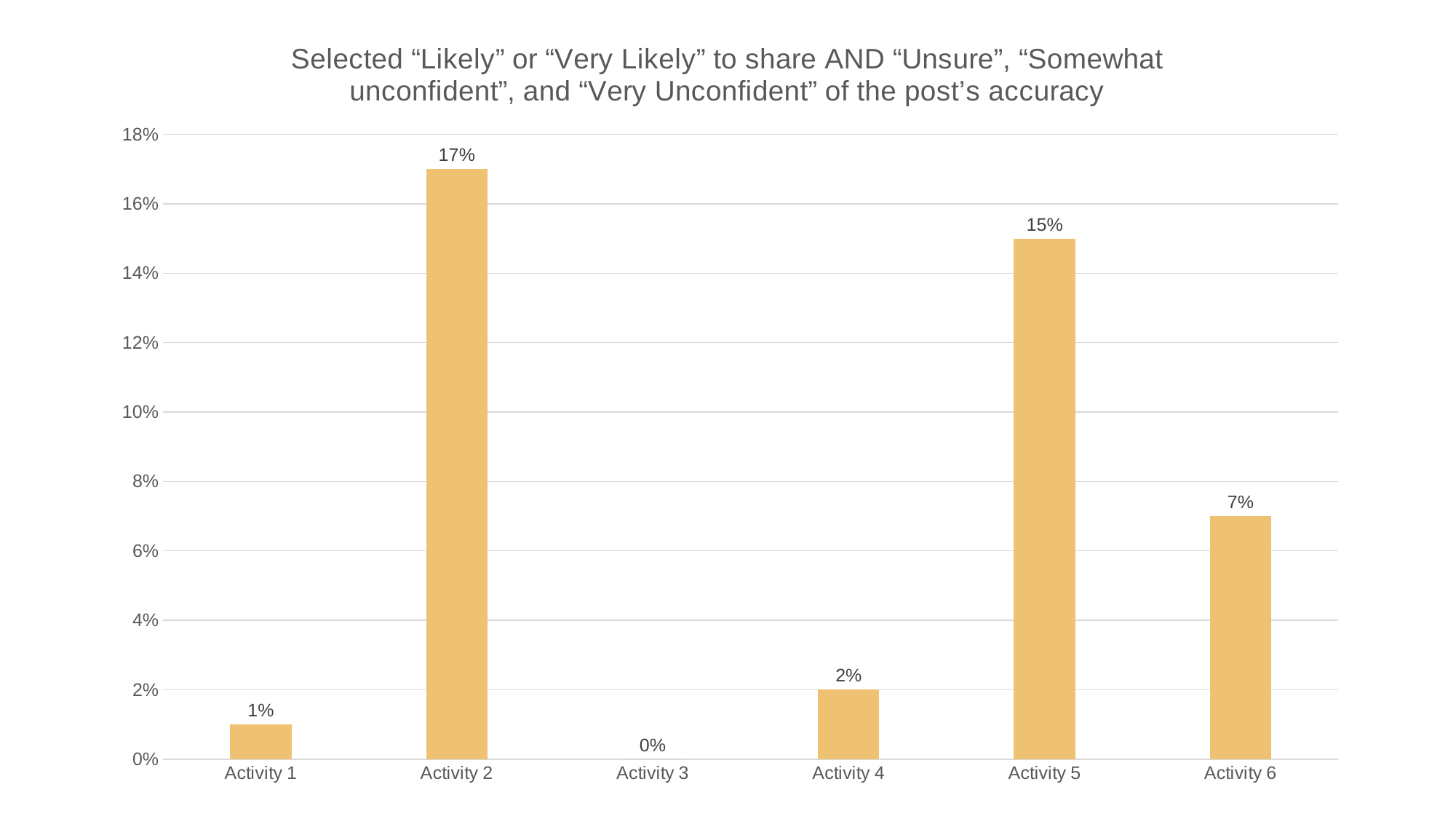
Which activity has the lowest value? Activity 3 Is the value for Activity 5 greater or less than 10%? greater Which activity has the highest value? Activity 2 What is the difference between the values for Activity 6 and Activity 4? 5% What kind of chart is shown on the slide? Bar chart How many activities are shown on the x axis? 6 What is the value for Activity 3? 0% What is the value for Activity 2? 17% What is the value for Activity 6? 7% Which is larger, the value for Activity 6 or the value for Activity 4? Activity 6 What is the difference between the values for Activity 2 and Activity 5? 2% What is the value for Activity 5? 15%